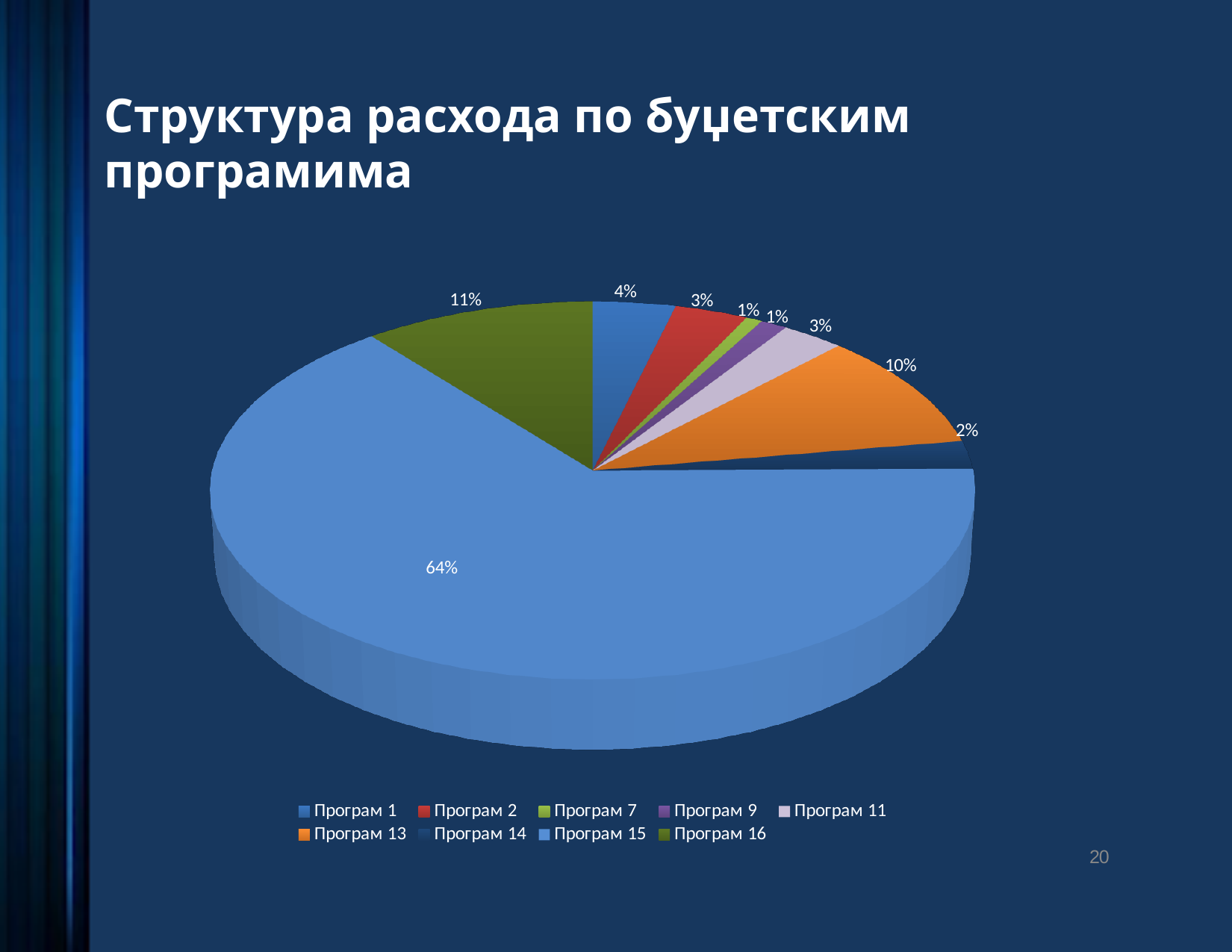
Which program has the largest slice of the pie? Програм 15 What share of the pie does Програм 16 have? 11% What share of the pie does Програм 15 have? 64% What colour is the slice for Програм 13? orange What share of the pie does Програм 13 have? 10% Which is larger, the slice for Програм 13 or the slice for Програм 16? Програм 16 What kind of chart is shown on the slide? pie chart How many programs are listed in the legend? 9 What is the difference between the shares of Програм 15 and Програм 16? 53% What is the value shown for Програм 14? 2% What is the value shown for Програм 1? 4% What is the title of the slide? Структура расхода по буџетским програмима